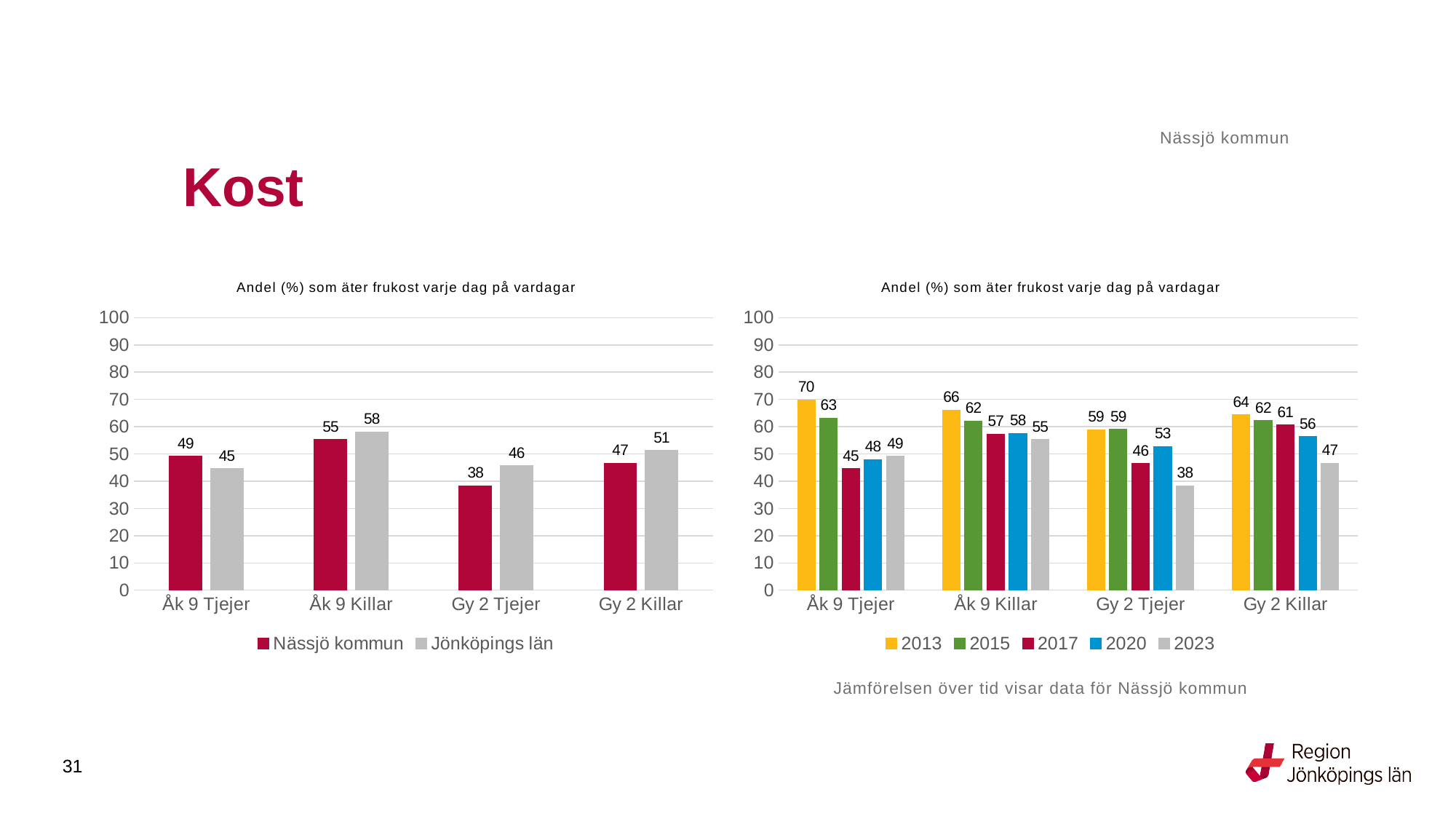
In the left chart, which is larger for Åk 9 Tjejer: Nässjö kommun or Jönköpings län? Nässjö kommun In the right chart, which year has the highest value for Gy 2 Killar? 2013 In the left chart, what is the value for Nässjö kommun for Gy 2 Tjejer? 38 How many series does the legend of the left chart list? 2 In the right chart, what is the value for 2023 for Gy 2 Tjejer? 38 In the right chart, what is the difference between 2013 and 2023 for Åk 9 Tjejer? 21 In the left chart, what is the difference between Jönköpings län and Nässjö kommun for Gy 2 Tjejer? 8 In the left chart, what is the value for Jönköpings län for Åk 9 Killar? 58 How many series does the legend of the right chart list? 5 In the right chart, what is the value for 2013 for Åk 9 Tjejer? 70 In the left chart, which category has the lowest value for Nässjö kommun? Gy 2 Tjejer What type of chart is the right chart? Bar chart